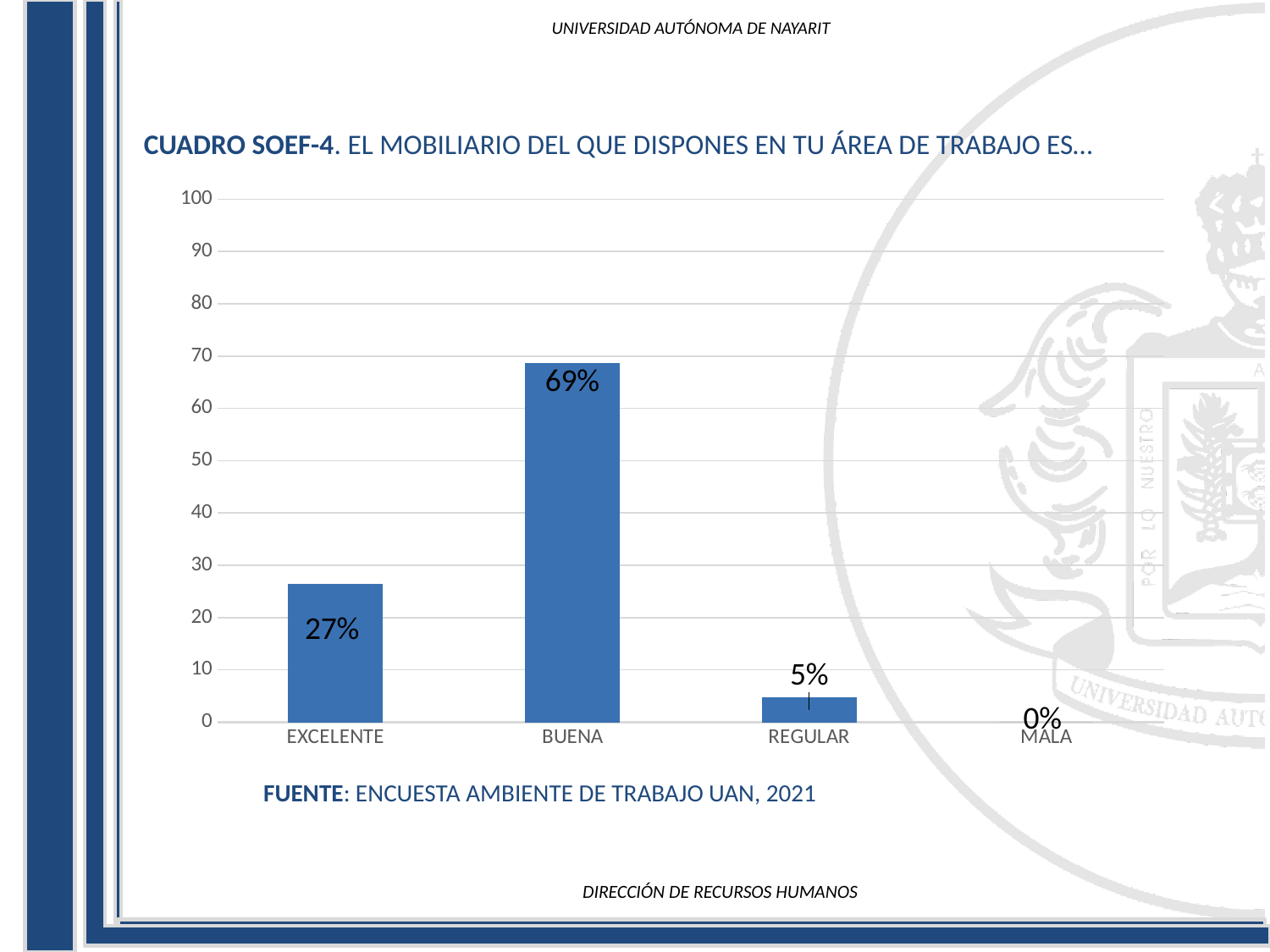
What is the source cited below the chart? ENCUESTA AMBIENTE DE TRABAJO UAN, 2021 What is the value for MALA? 0% Is the value for BUENA greater or less than 60? greater What is the value for EXCELENTE? 27% What is the difference between the values for BUENA and EXCELENTE? 42% Which category has the lowest value? MALA Which is larger, the value for EXCELENTE or the value for REGULAR? EXCELENTE What kind of chart is shown on the slide? Bar chart Which category has the highest value? BUENA What is the value for BUENA? 69% How many categories are shown on the x axis? 4 What is the value for REGULAR? 5%